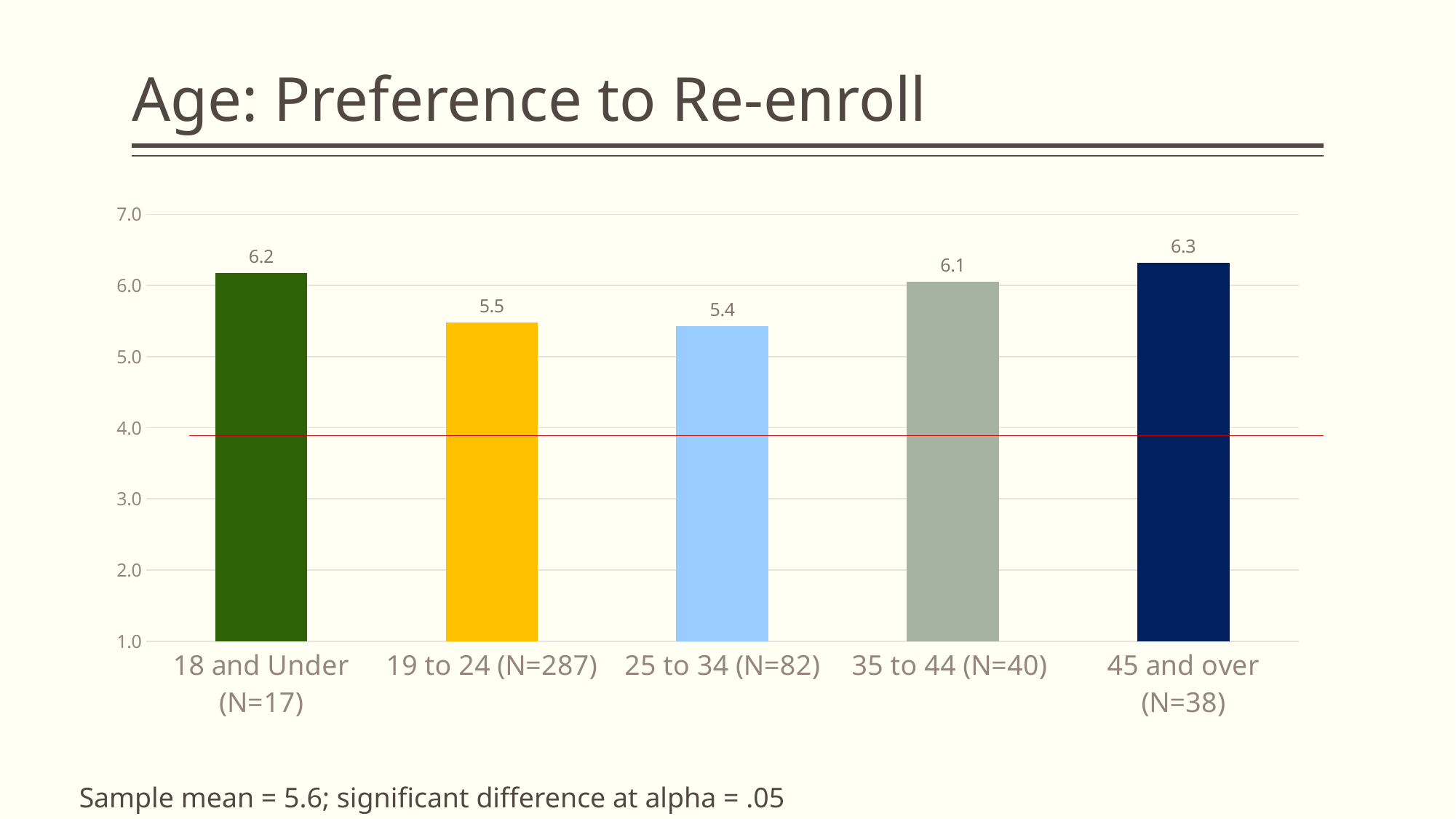
Which age group has the lowest value? 25 to 34 (N=82) What is the difference between the values for 45 and over (N=38) and 25 to 34 (N=82)? 0.9 How many age groups are shown in the chart? 5 What kind of chart is shown on the slide? bar chart Which is larger, the value for 35 to 44 (N=40) or the value for 19 to 24 (N=287)? 35 to 44 (N=40) What is the value for 18 and Under (N=17)? 6.2 What is the value for 19 to 24 (N=287)? 5.5 What is the difference between the values for 18 and Under (N=17) and 19 to 24 (N=287)? 0.7 What is the value for 35 to 44 (N=40)? 6.1 Which age group has the highest value? 45 and over (N=38) Is the value for 25 to 34 (N=82) greater or less than 6.0? less What is the title of the slide? Age: Preference to Re-enroll